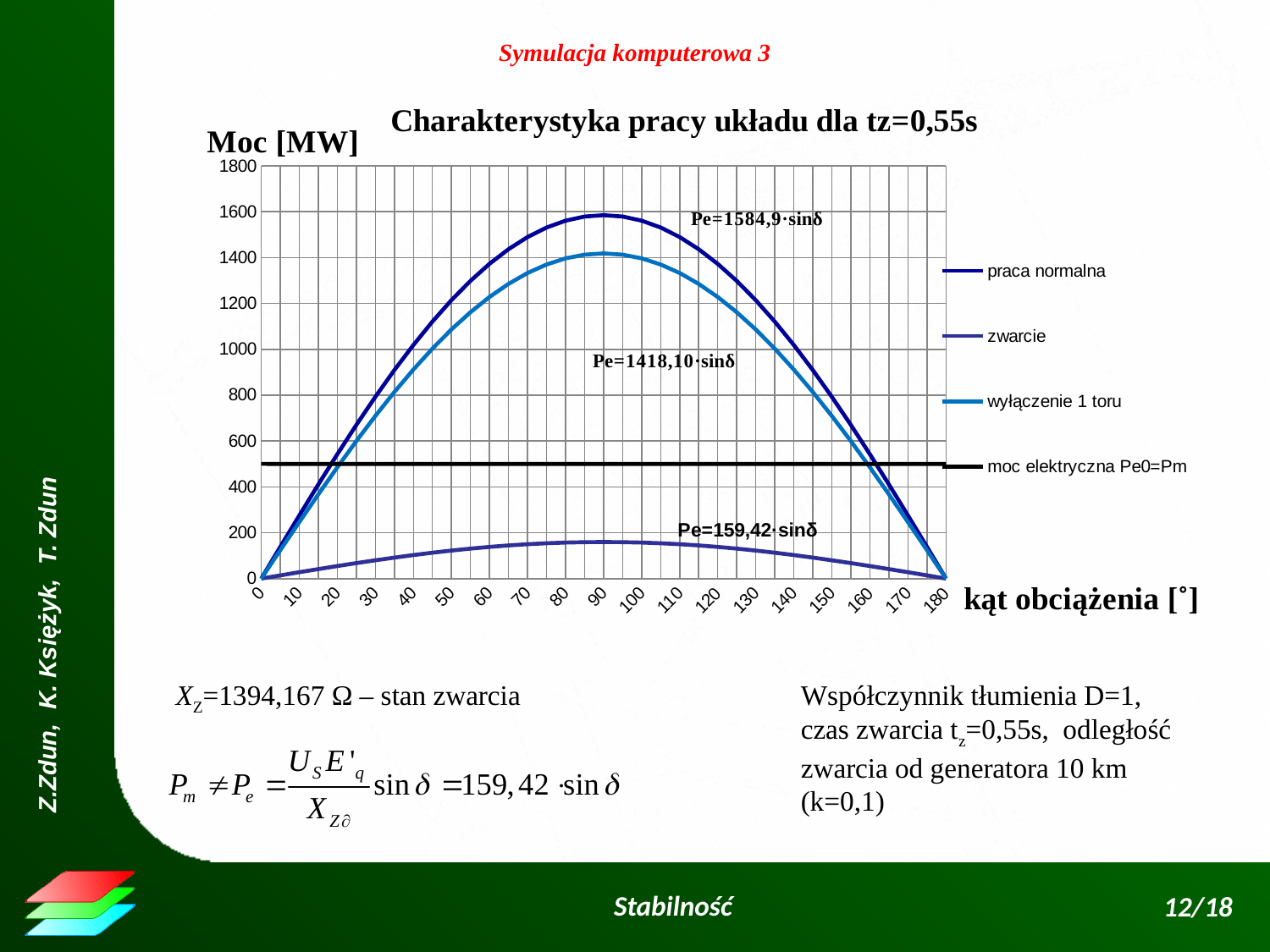
What kind of chart is shown on the slide? line chart What formula label is printed next to the zwarcie curve? Pe=159,42·sinδ Is the value of wyłączenie 1 toru at 90° greater or less than 1200? greater Is the value of zwarcie at 90° greater or less than 200? less Does the praca normalna curve rise or fall as the load angle increases from 90° to 180°? fall What is the label of the vertical axis? Moc [MW] Which series reaches the highest value at a load angle of 90°? praca normalna What is the title of the chart? Charakterystyka pracy układu dla tz=0,55s Is the value of praca normalna at 90° greater or less than 1400? greater Which curve has the lowest peak value? zwarcie How many series does the legend list? 4 At a load angle of 90°, which is larger: praca normalna or wyłączenie 1 toru? praca normalna